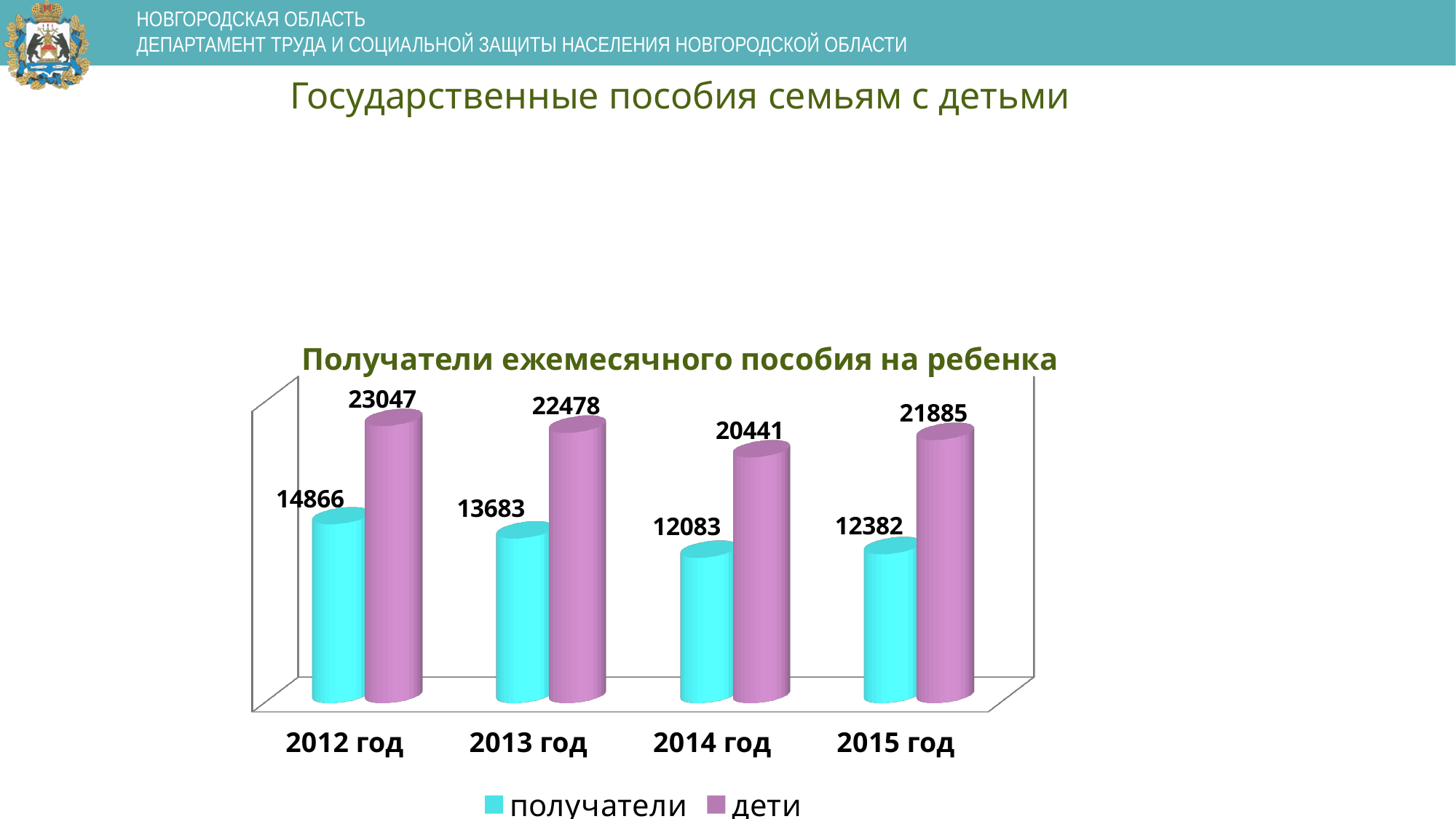
Which is larger: получатели in 2013 год or получатели in 2015 год? 2013 год Which year has the lowest value for получатели? 2014 год What is the value for получатели in 2012 год? 14866 What is the value for дети in 2014 год? 20441 What is the difference between дети and получатели in 2013 год? 8795 What is the difference between the получатели values for 2012 год and 2015 год? 2484 How many series does the legend list? 2 What kind of chart is shown? Bar chart What is the title of the chart? Получатели ежемесячного пособия на ребенка What is the value for дети in 2015 год? 21885 How many years are shown on the x axis? 4 Which year has the highest value for дети? 2012 год